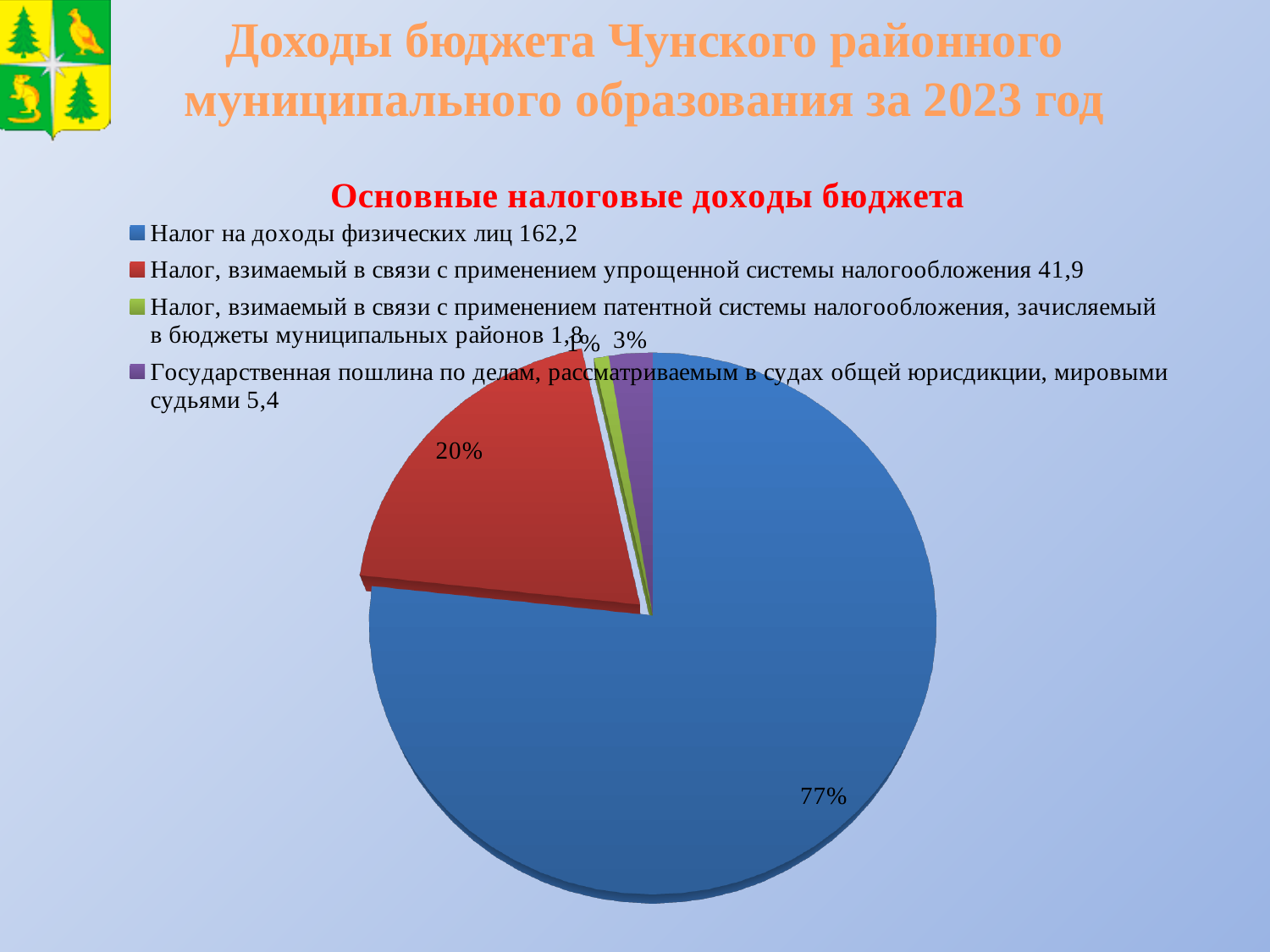
What type of chart is shown on the slide? pie chart Which category has the largest slice of the pie? Налог на доходы физических лиц What value is given in the legend for "Государственная пошлина по делам, рассматриваемым в судах общей юрисдикции, мировыми судьями"? 5,4 What share of the pie does "Налог, взимаемый в связи с применением упрощенной системы налогообложения" take? 20% What share of the pie does "Государственная пошлина по делам, рассматриваемым в судах общей юрисдикции, мировыми судьями" take? 3% What share of the pie does "Налог на доходы физических лиц" take? 77% What is the title of the chart? Основные налоговые доходы бюджета What value is given in the legend for "Налог на доходы физических лиц"? 162,2 What value is given in the legend for "Налог, взимаемый в связи с применением упрощенной системы налогообложения"? 41,9 Which is larger: the share for "Государственная пошлина" or the share for the patent-system tax ("патентной системы налогообложения")? Государственная пошлина How many slices does the pie chart have? 4 Which category has the smallest slice of the pie? Налог, взимаемый в связи с применением патентной системы налогообложения, зачисляемый в бюджеты муниципальных районов